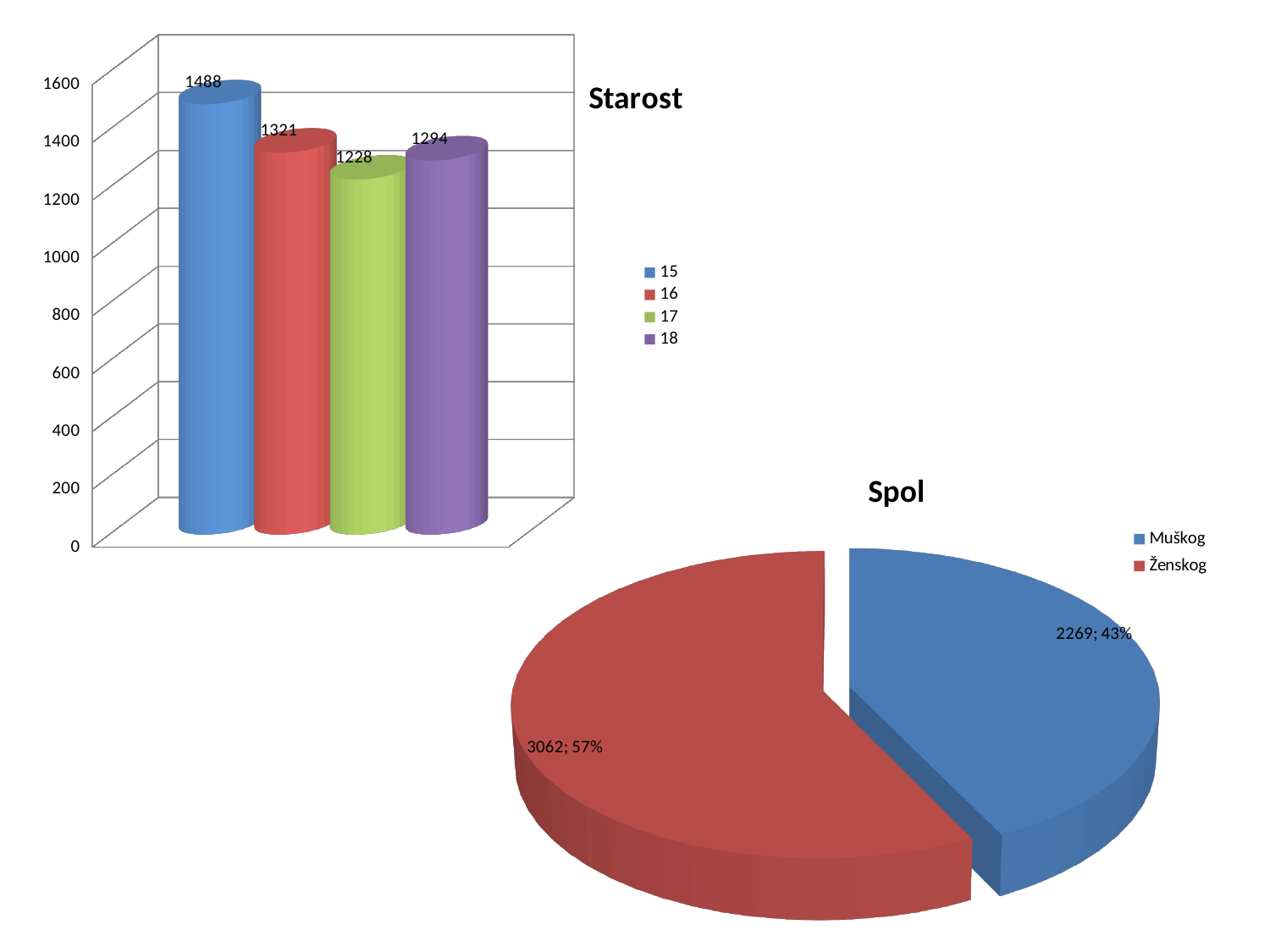
In the Starost chart, what is the value for age 17? 1228 In the Spol chart, which category is larger, Muškog or Ženskog? Ženskog In the Starost chart, what is the value for age 15? 1488 How many entries does the legend of the Spol chart list? 2 In the Starost chart, which is larger, the value for age 16 or the value for age 18? 16 In the Starost chart, which age has the lowest value? 17 What kind of chart is the Starost chart? bar chart In the Starost chart, how many age categories are shown? 4 In the Starost chart, which age has the highest value? 15 In the Spol chart, what share of the pie does Muškog represent? 43% In the Spol chart, what is the value for Ženskog? 3062 In the Starost chart, what is the difference between the values for age 15 and age 16? 167